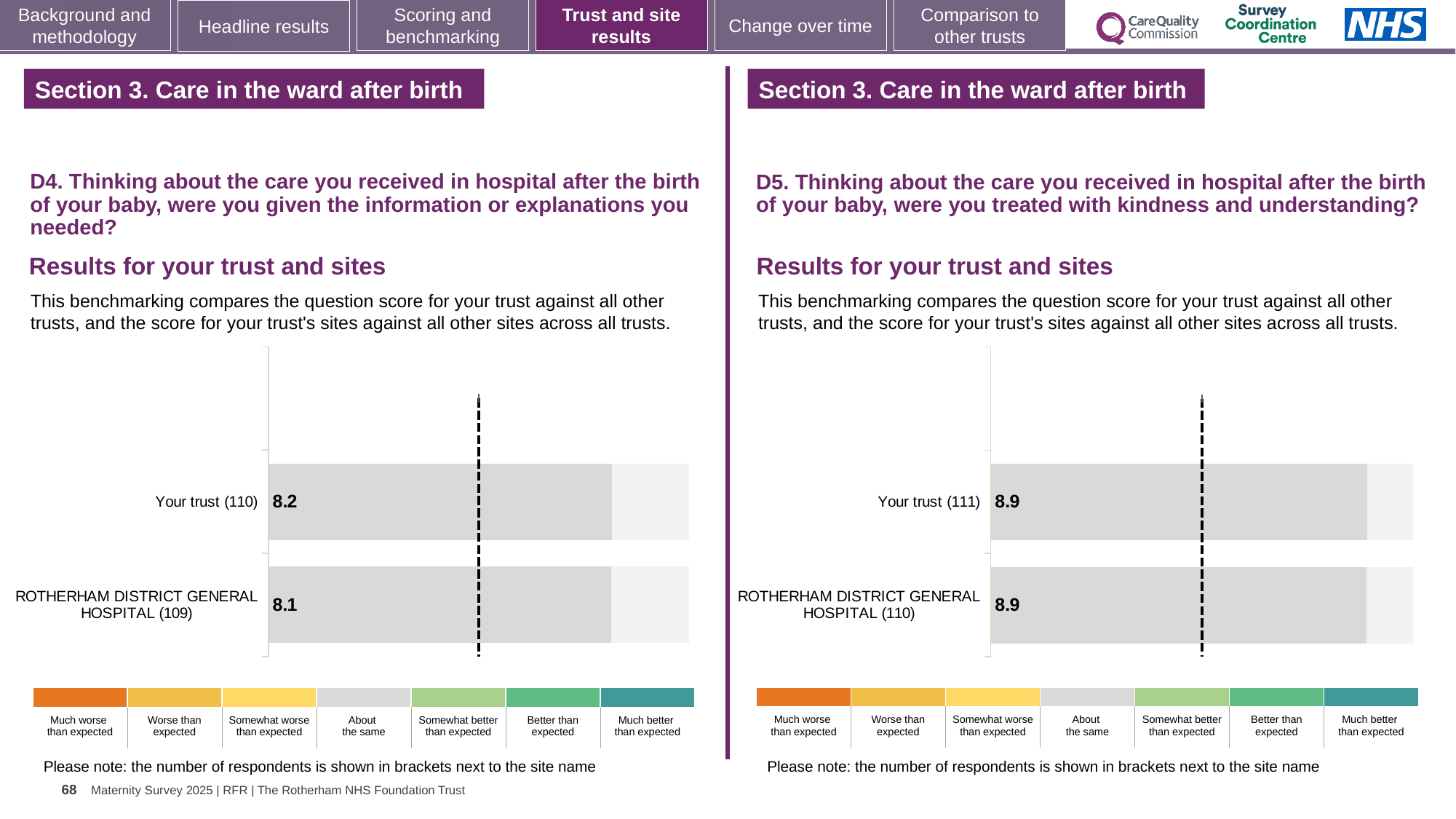
On the left chart (D4), how many bars are plotted? 2 On the left chart (D4), what is the score for Rotherham District General Hospital? 8.1 On the right chart (D5), what is the score for Rotherham District General Hospital? 8.9 Is the score for Your trust on the right chart (D5) higher or lower than the score for Your trust on the left chart (D4)? Higher On the right chart (D5), how many bars are plotted? 2 What type of chart is used on the left (D4) to show the results? Bar chart On the right chart (D5), what is the score for Your trust? 8.9 On the right chart (D5), what is the difference between the score for Your trust and the score for Rotherham District General Hospital? 0 On the left chart (D4), what is the score for Your trust? 8.2 On the left chart (D4), how many respondents are shown in brackets for Your trust? 110 On the right chart (D5), how many respondents are shown in brackets for Rotherham District General Hospital? 110 On the left chart (D4), what is the difference between the score for Your trust and the score for Rotherham District General Hospital? 0.1